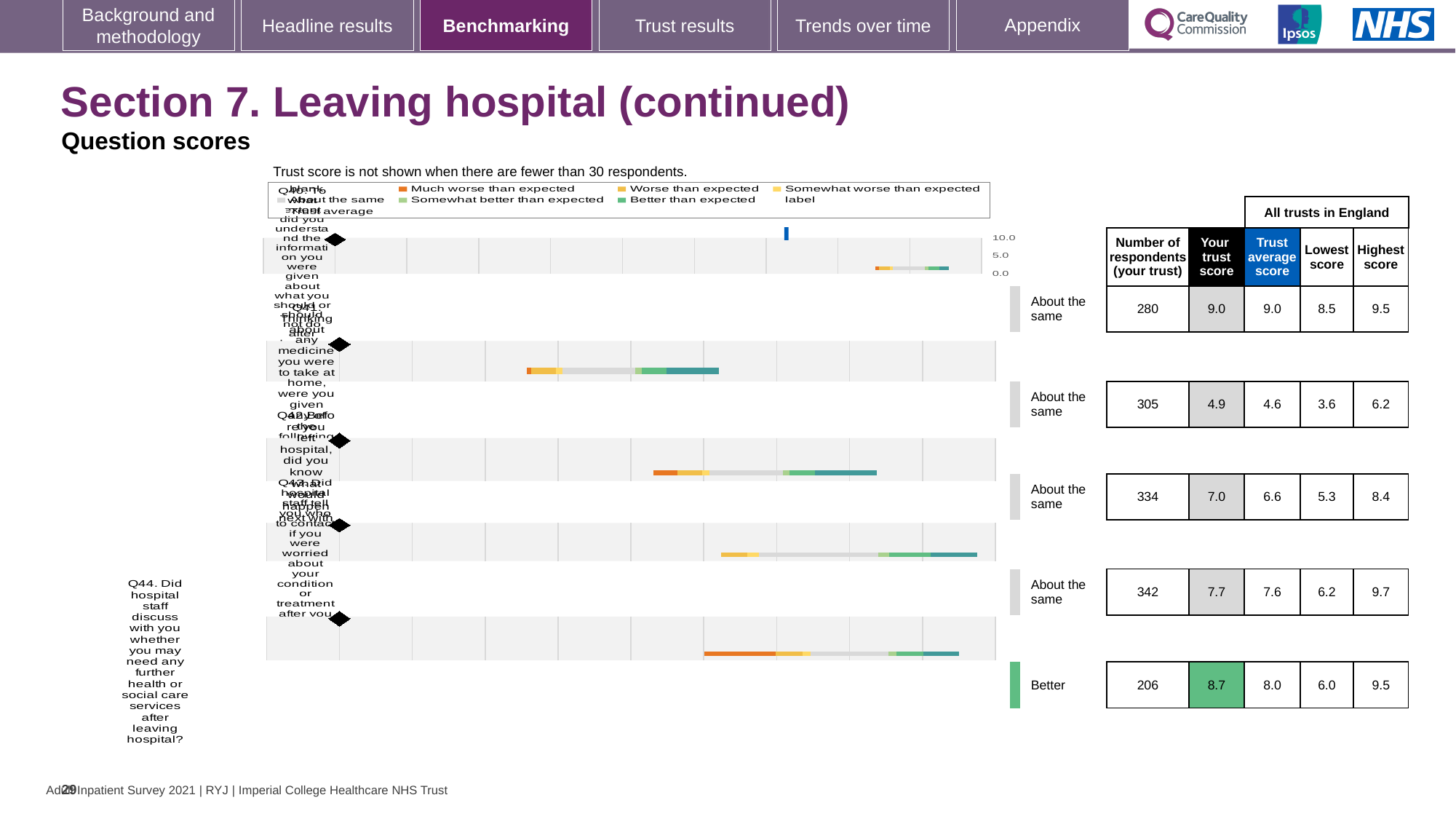
What is the highest score across all trusts in England for Q44? 9.5 Is the trust score for Q44 higher or lower than the trust average score? Higher How many respondents answered Q44 at this trust? 206 What is the difference between the trust score and the trust average score for Q44? 0.7 Which question row has the highest 'Your trust score' in the table? The first row (9.0) What is the lowest score across all trusts in England for Q44? 6.0 What benchmark category is shown for Q44? Better What is the trust score for Q44 (whether you may need further health or social care services after leaving hospital)? 8.7 What is the maximum value shown on the chart's score axis? 10.0 What is the trust average score for Q44? 8.0 Which question row has the lowest 'Your trust score' in the table? The second row (4.9) How many question rows are shown in the chart? 5